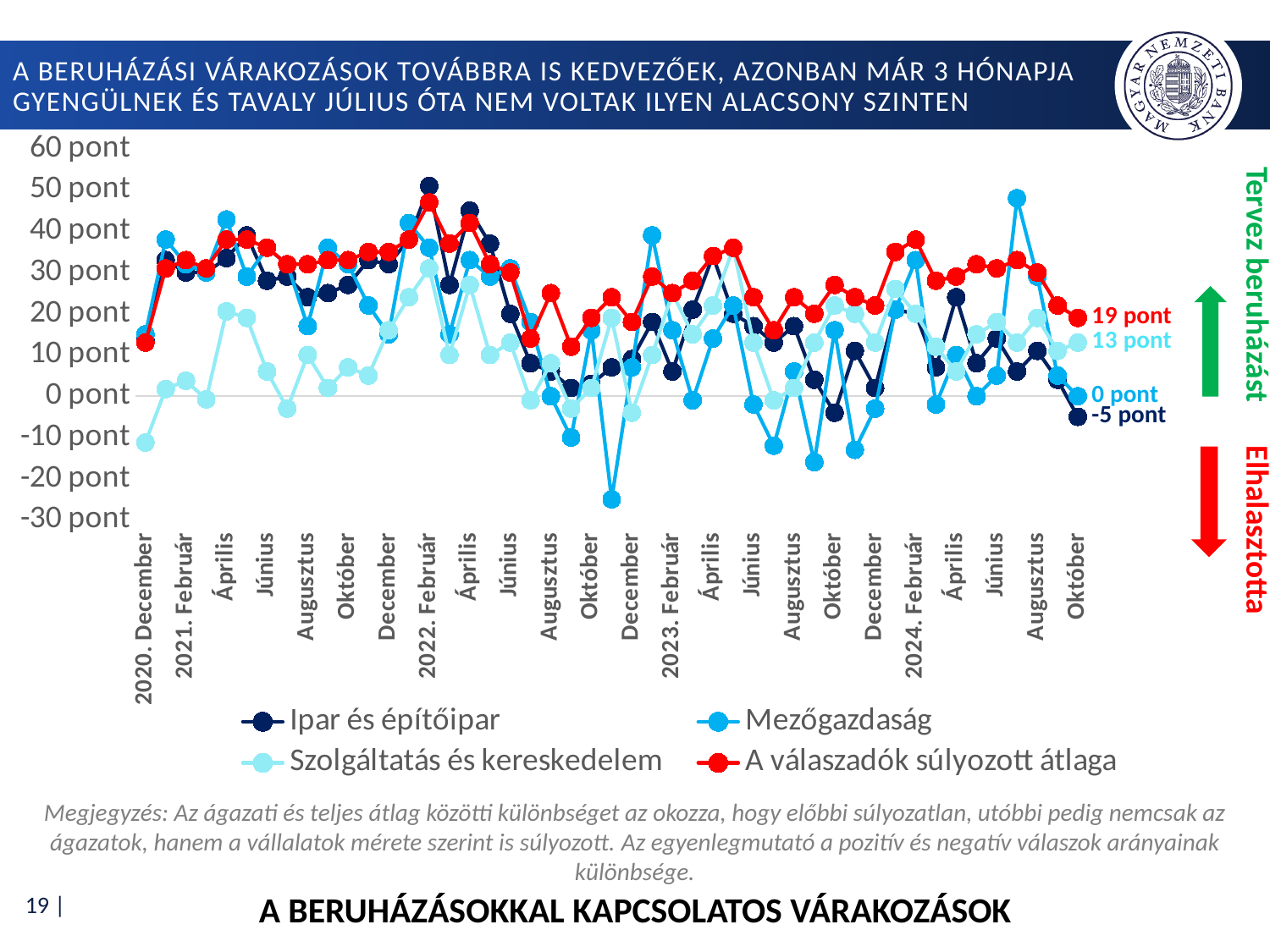
What is the latest (2024 October) value shown for the series 'A válaszadók súlyozott átlaga'? 19 pont What is the latest value labelled for the series 'Mezőgazdaság'? 0 pont Which series has the lowest value at the last data point (2024 October)? Ipar és építőipar What kind of chart is shown on the slide? Line chart Which series has the highest value at the last data point (2024 October)? A válaszadók súlyozott átlaga What is the latest value labelled for the series 'Ipar és építőipar'? -5 pont Is the value for 'Mezőgazdaság' in 2022 December greater or less than -20 pont? greater How many series does the legend list? 4 What is the difference between the latest labelled values of 'A válaszadók súlyozott átlaga' and 'Ipar és építőipar'? 24 pont Is the value for 'Mezőgazdaság' in 2024 Augusztus greater or less than 40 pont? less At the last data point, which is larger: the value for 'Szolgáltatás és kereskedelem' or the value for 'Mezőgazdaság'? Szolgáltatás és kereskedelem What is the latest value labelled for the series 'Szolgáltatás és kereskedelem'? 13 pont